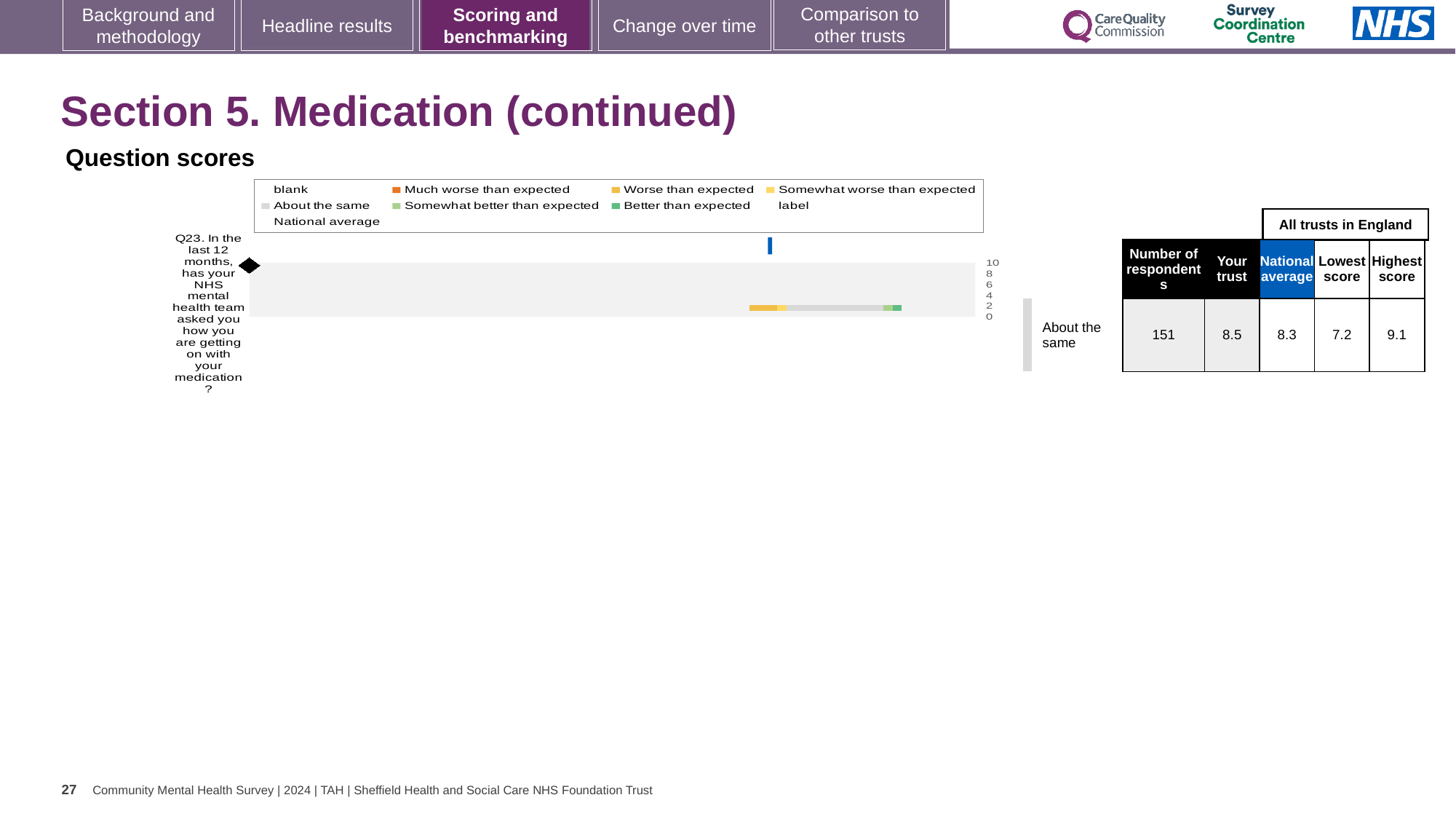
What is the difference between the 'Your trust' score and the national average for Q23? 0.2 What is the lowest score among all trusts in England for Q23? 7.2 What is the national average score for Q23? 8.3 What is the 'Your trust' score for Q23? 8.5 Which is larger for Q23, the 'Your trust' score or the national average? Your trust What benchmarking category is shown next to the chart for Q23? About the same What is the difference between the highest and lowest scores among all trusts in England for Q23? 1.9 How many respondents answered Q23? 151 What is the highest score among all trusts in England for Q23? 9.1 What kind of chart is shown under 'Question scores'? bar chart How many questions (categories) are plotted on the chart? 1 Which question is plotted on the chart? Q23. In the last 12 months, has your NHS mental health team asked you how you are getting on with your medication?